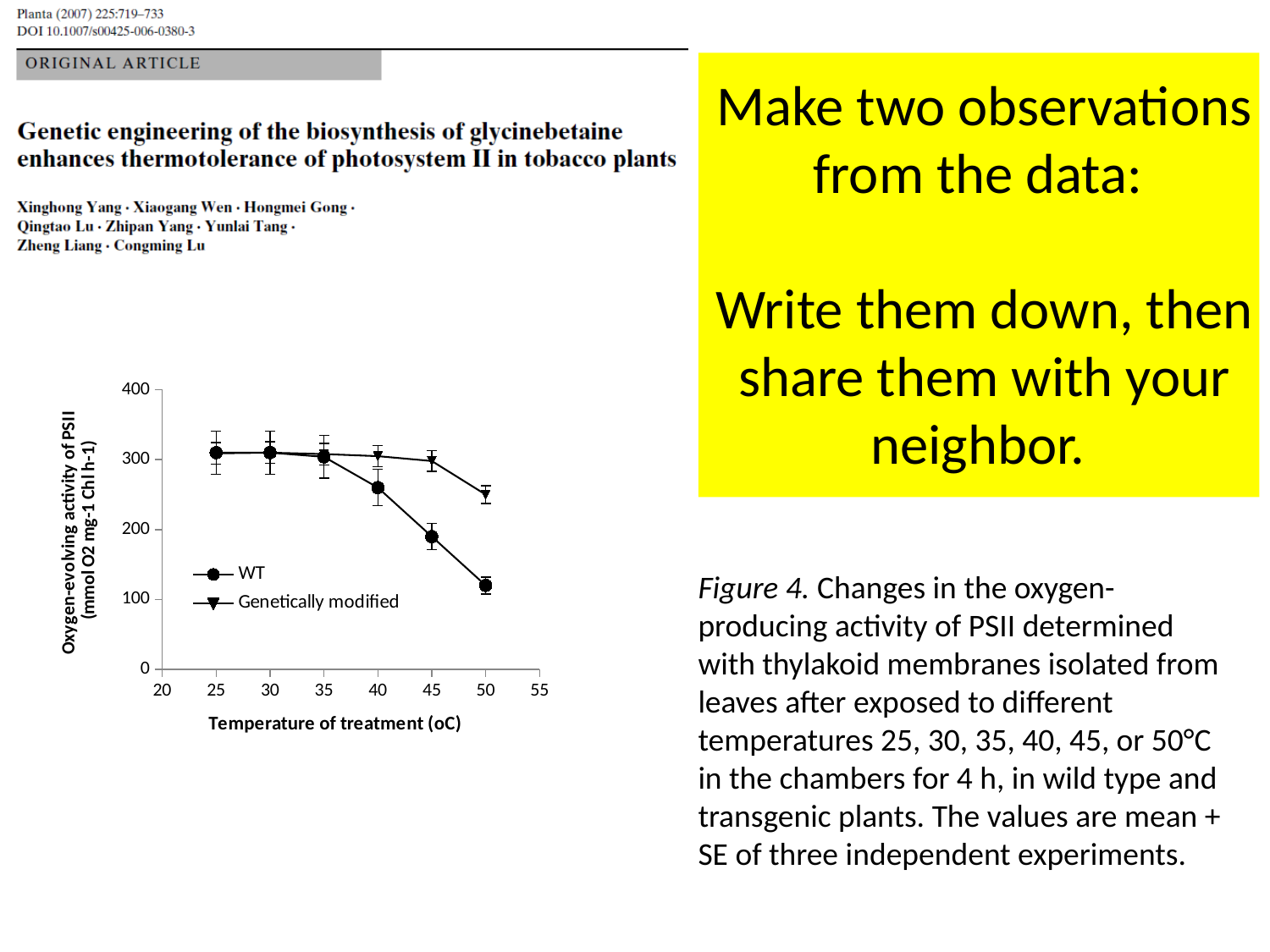
How many series does the legend list? 2 What is the label of the x axis? Temperature of treatment (oC) How many temperature points are plotted for each series? 6 Is the Genetically modified value at 45 greater or less than 200? greater Is the WT value at 40 greater or less than 200? greater Is the Genetically modified value at 50 greater or less than 200? greater What are the two series named in the legend? WT and Genetically modified At 50, which series has the higher oxygen-evolving activity, WT or Genetically modified? Genetically modified What kind of chart is shown on the slide? line chart Does the WT series rise or fall as temperature increases from 35 to 50? fall At which temperature is the WT series at its lowest? 50